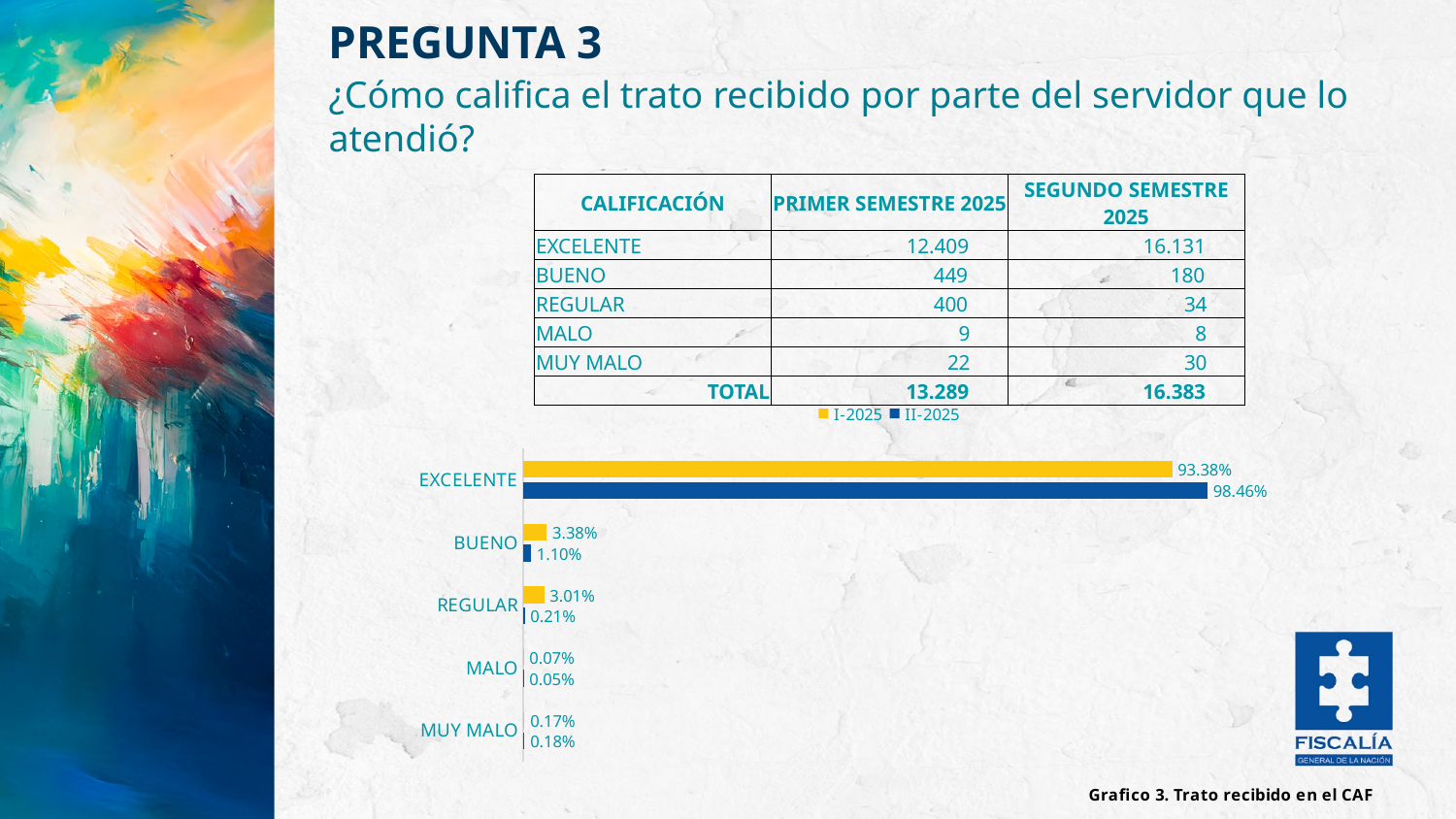
What is the value for EXCELENTE in the I-2025 series? 93.38% What is the difference between the II-2025 and I-2025 values for EXCELENTE? 5.08% How many series does the chart legend list? 2 Which category has the lowest value in the I-2025 series? MALO How many categories are plotted in the chart? 5 What is the value for EXCELENTE in the II-2025 series? 98.46% What is the value for REGULAR in the I-2025 series? 3.01% Which is larger for BUENO: the I-2025 value or the II-2025 value? I-2025 Which category has the highest value in the II-2025 series? EXCELENTE What type of chart is shown on the slide? bar chart What is the value for MUY MALO in the II-2025 series? 0.18% What is the value for BUENO in the II-2025 series? 1.10%